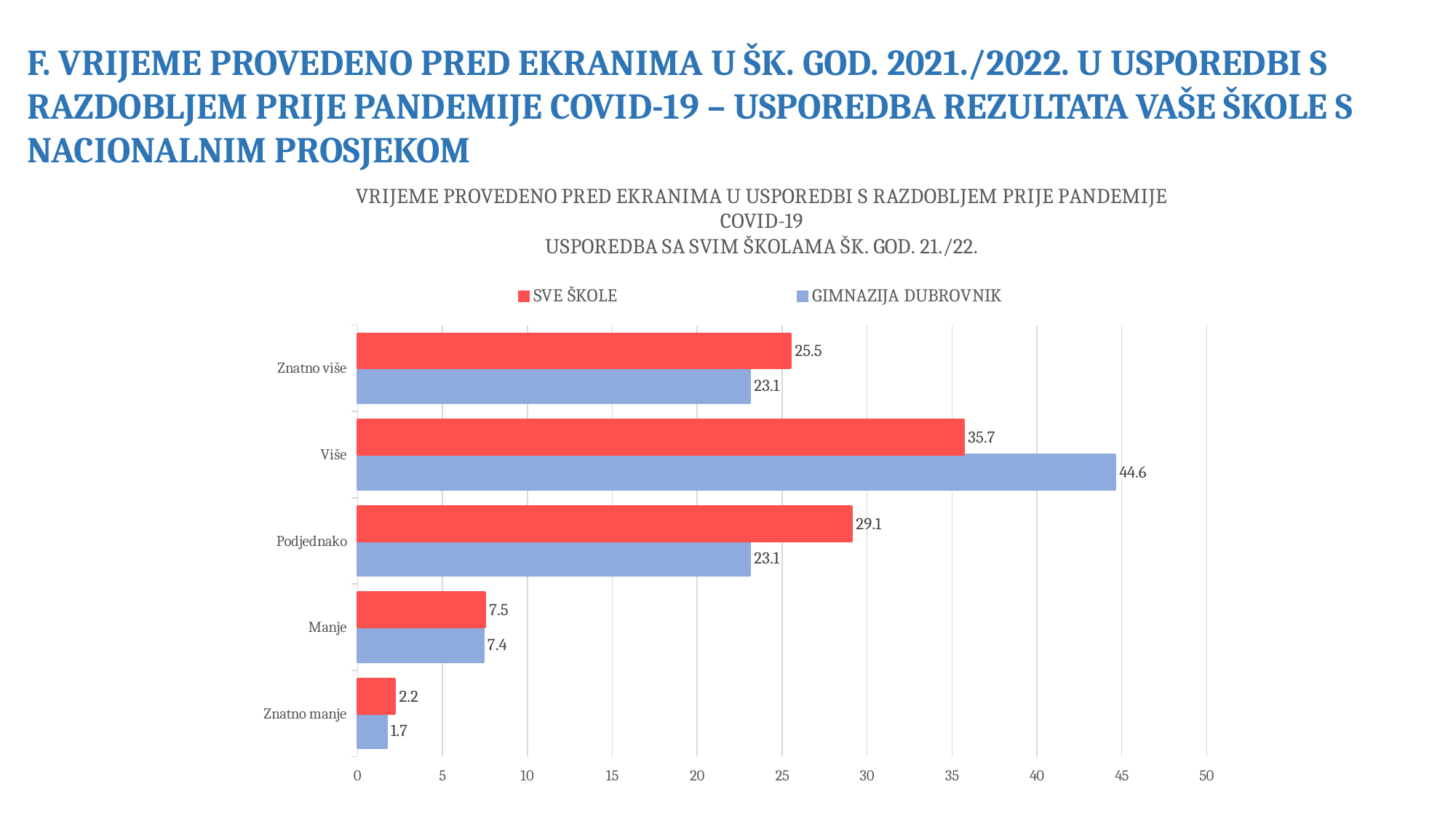
What is the value for SVE ŠKOLE in the Podjednako category? 29.1 What is the value for GIMNAZIJA DUBROVNIK in the Više category? 44.6 Which category has the lowest value for SVE ŠKOLE? Znatno manje Which colour represents the SVE ŠKOLE series? Red What is the value for SVE ŠKOLE in the Znatno manje category? 2.2 In the Podjednako category, which series has the larger value, SVE ŠKOLE or GIMNAZIJA DUBROVNIK? SVE ŠKOLE What kind of chart is shown on the slide? Bar chart How many categories are shown on the chart? 5 What is the difference between SVE ŠKOLE and GIMNAZIJA DUBROVNIK in the Znatno više category? 2.4 Which category has the highest value for GIMNAZIJA DUBROVNIK? Više What is the difference between GIMNAZIJA DUBROVNIK and SVE ŠKOLE in the Više category? 8.9 How many series does the legend list? 2